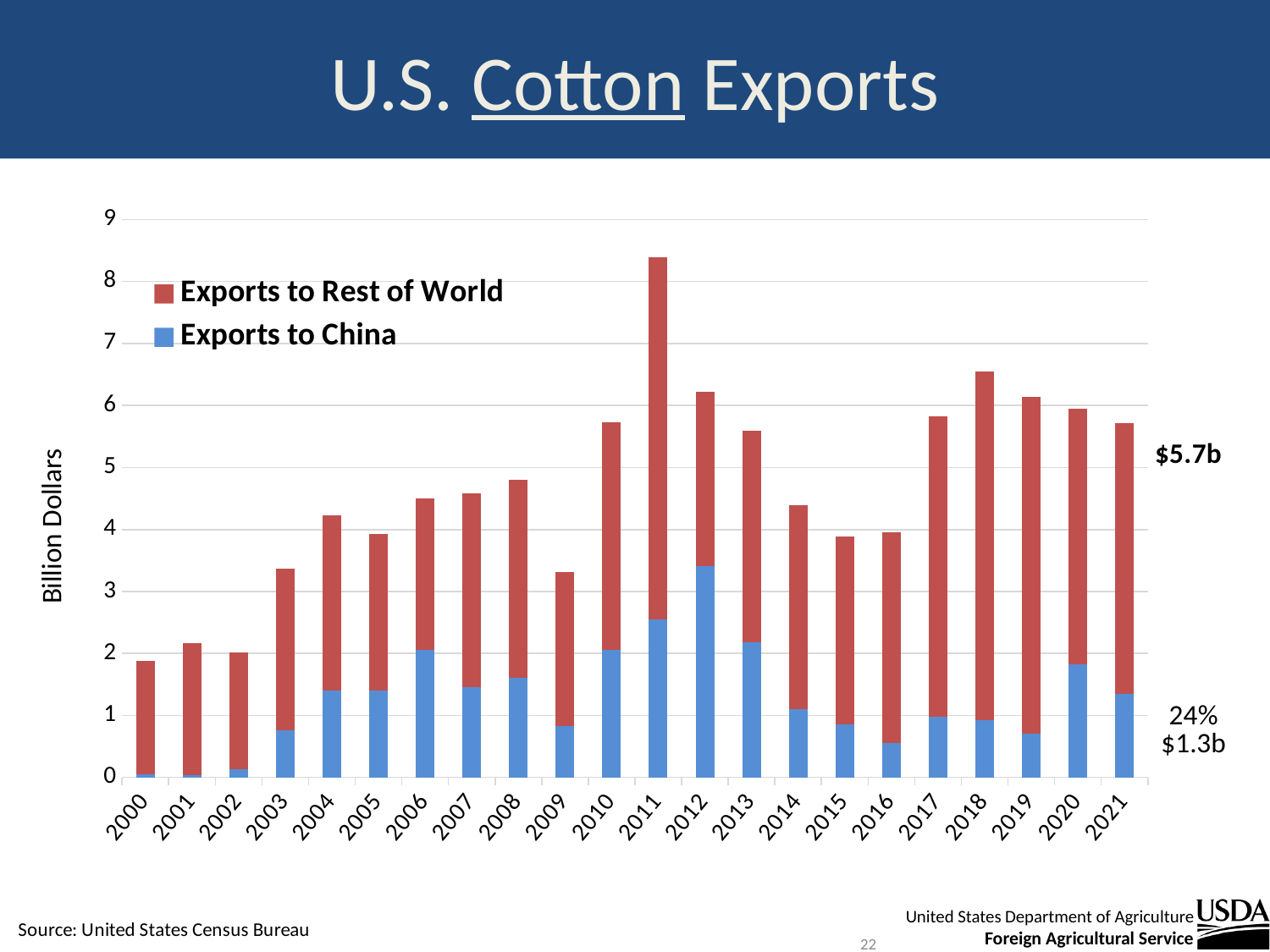
How many series does the legend list? 2 What is the total value of U.S. cotton exports labeled for 2021? $5.7b What kind of chart is shown on the slide? bar chart Do total cotton exports rise or fall from 2018 to 2021? fall What share of 2021 cotton exports went to China, as labeled on the slide? 24% Is the total value for 2011 greater or less than 8? greater Which year has larger exports to China, 2011 or 2012? 2012 What is the label on the y axis? Billion Dollars What is the value of exports to China labeled for 2021? $1.3b Which year has the highest total cotton exports? 2011 Is the value of exports to China in 2012 greater or less than 3? greater How many years are shown along the x axis? 22